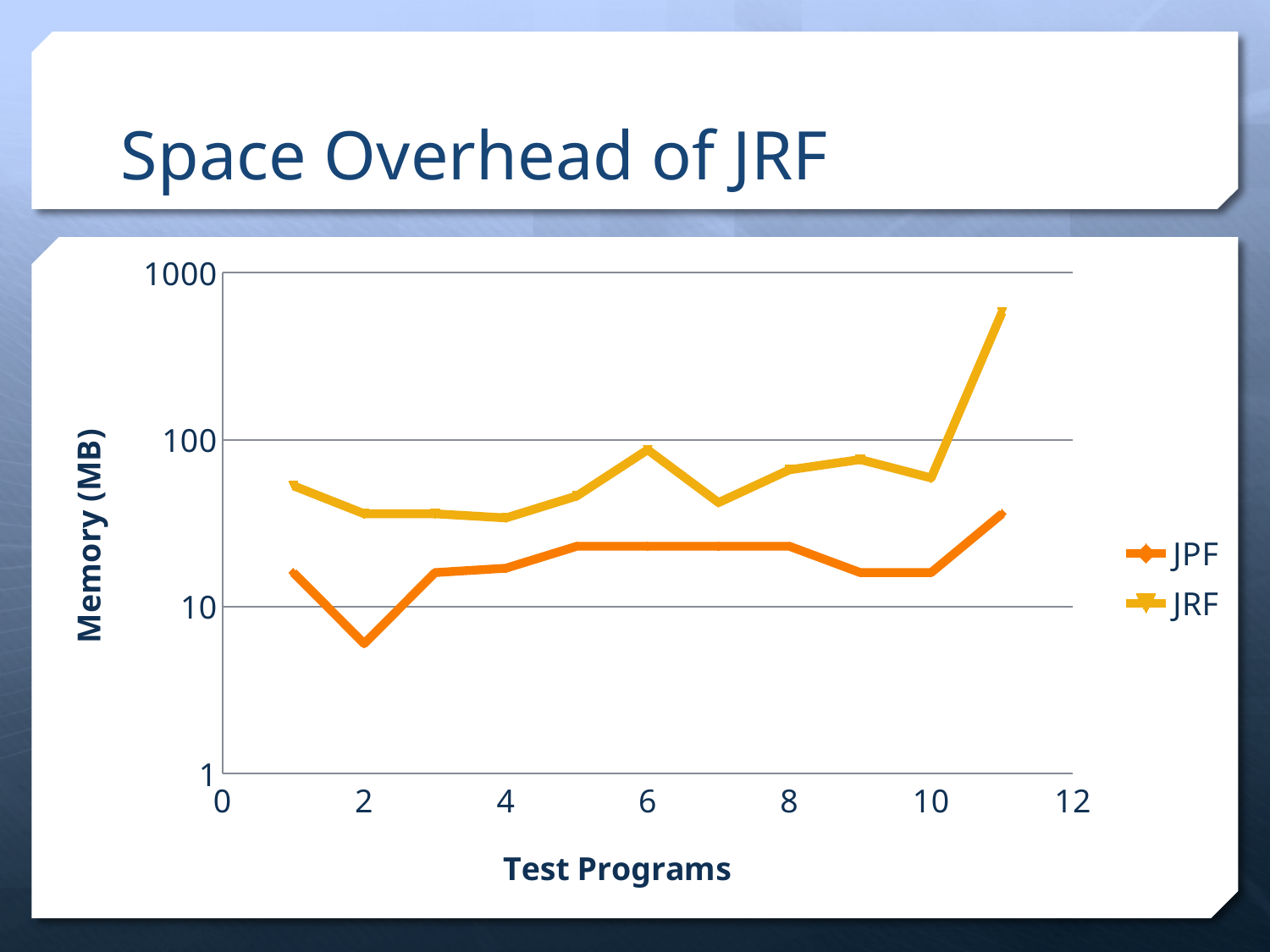
What kind of chart is shown on the slide? line chart Is the JPF memory value for test program 5 greater or less than 100? less At which test program does the JPF series reach its lowest memory value? 2 Is the JRF memory value for test program 11 greater or less than 100? greater Is the JRF memory value for test program 1 greater or less than 10? greater How many test programs (data points) are plotted for each series? 11 What is the label of the vertical axis? Memory (MB) At which test program does the JRF series reach its highest memory value? 11 How many series does the legend list? 2 At test program 6, which series has the larger memory value, JPF or JRF? JRF Which series reaches the highest memory value on the chart? JRF